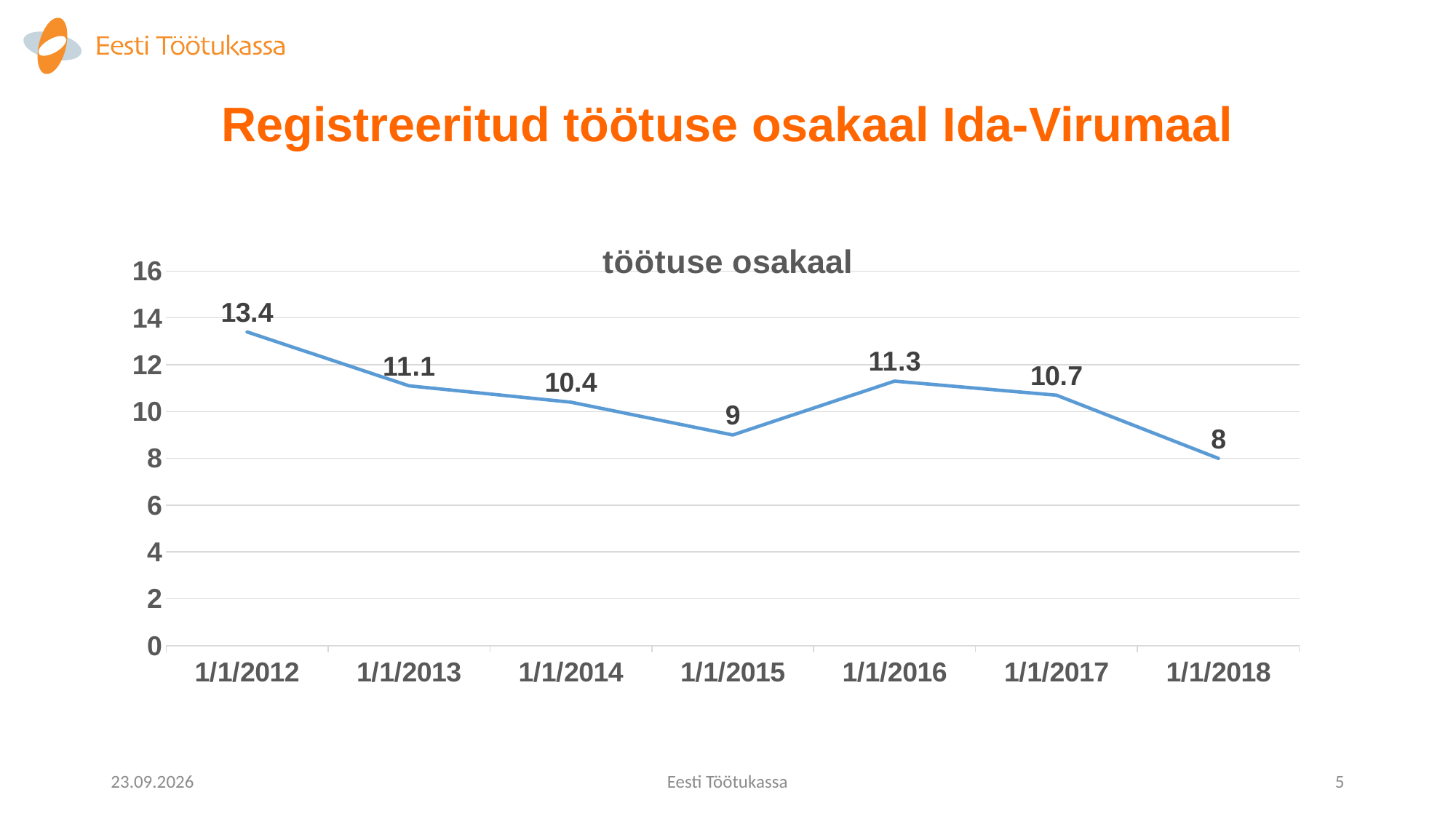
How many data points are plotted on the chart? 7 What is the value for 1/1/2012? 13.4 Which date has the lowest value? 1/1/2018 What is the value for 1/1/2015? 9 What kind of chart is shown on the slide? line chart Is the value for 1/1/2014 greater or less than 10? greater What is the difference between the values for 1/1/2012 and 1/1/2018? 5.4 Which date has the highest value? 1/1/2012 What is the difference between the values for 1/1/2016 and 1/1/2015? 2.3 What is the title of the chart? töötuse osakaal What is the value for 1/1/2017? 10.7 Which is larger, the value for 1/1/2013 or the value for 1/1/2016? 1/1/2016